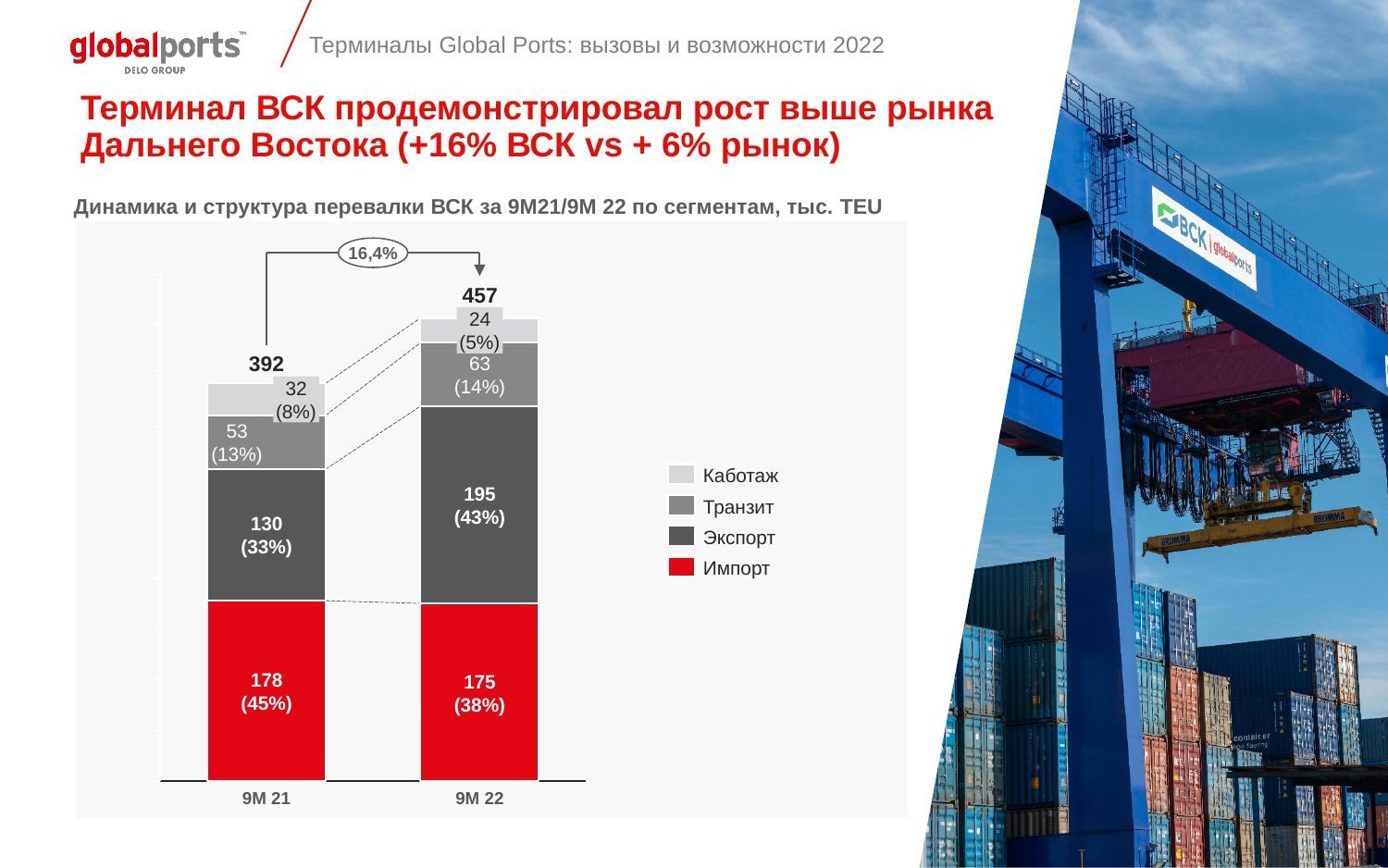
What share of the 9M 21 total does Транзит represent, as labelled on the chart? 13% Which is larger: Импорт in 9M 21 or Импорт in 9M 22? Импорт in 9M 21 What is the value of Экспорт for 9M 22? 195 What type of chart is shown on the slide? Stacked bar chart By how much did Экспорт increase from 9M 21 to 9M 22? 65 What is the value of Импорт for 9M 21? 178 How many categories (periods) are shown on the x axis? 2 What is the total value of the 9M 22 bar? 457 What is the total value of the 9M 21 bar? 392 What is the value of Каботаж for 9M 22? 24 What percentage growth is shown between the 9M 21 and 9M 22 bars? 16,4% How many series does the legend list? 4